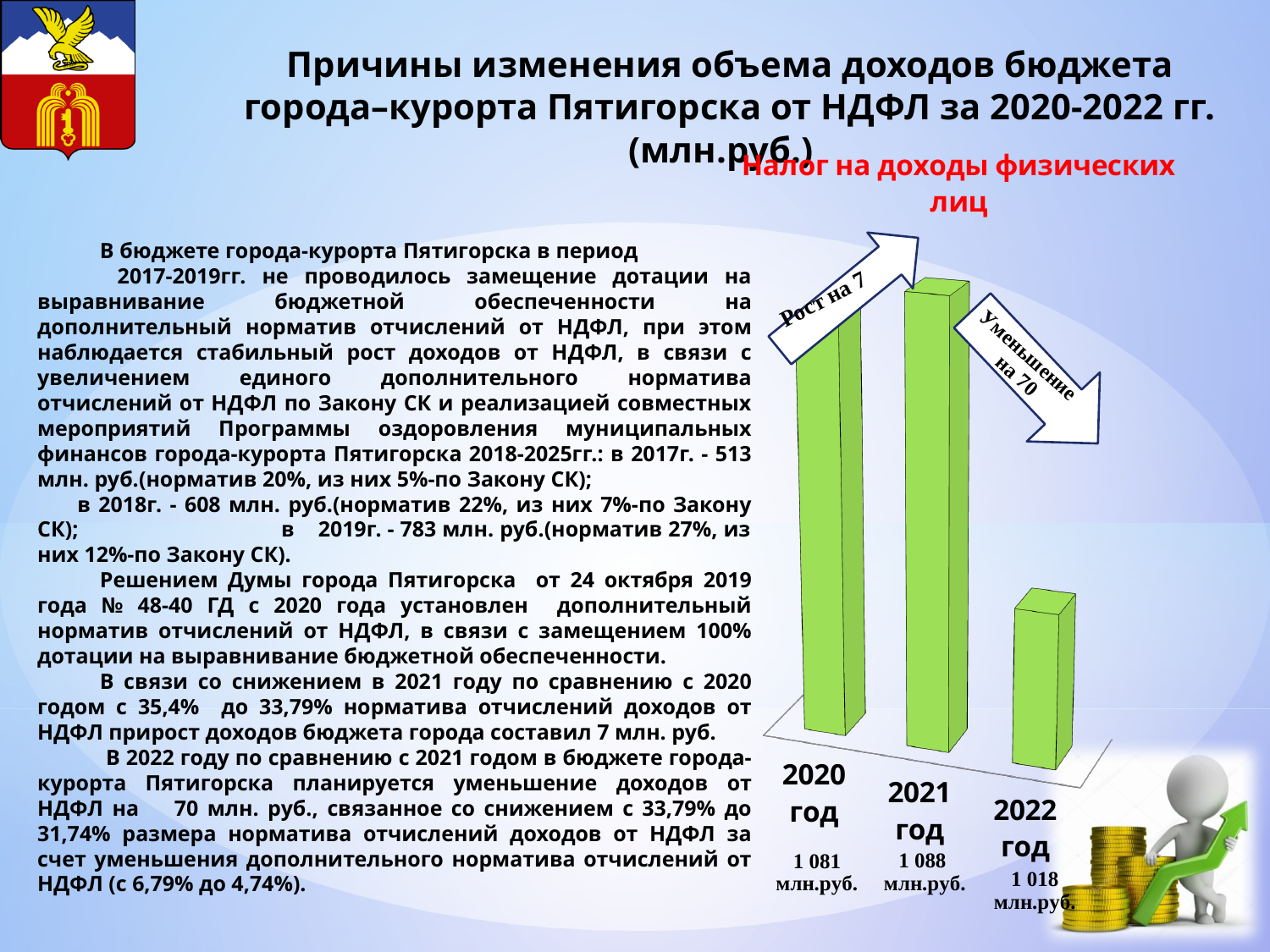
Which is larger, the value for 2020 год or the value for 2022 год? 2020 год What is the value shown for 2021 год on the chart? 1 088 млн.руб. How many years (bars) are shown on the chart? 3 What is the value shown for 2020 год on the chart? 1 081 млн.руб. What is the value shown for 2022 год on the chart? 1 018 млн.руб. What is the difference between the values for 2021 год and 2020 год? 7 млн.руб. Which year has the highest value on the chart? 2021 год What kind of chart is shown on the slide? Bar chart What does the arrow between the 2021 and 2022 bars say? Уменьшение на 70 Which year has the lowest value on the chart? 2022 год What is the difference between the values for 2021 год and 2022 год? 70 млн.руб. What is the title of the chart? Налог на доходы физических лиц